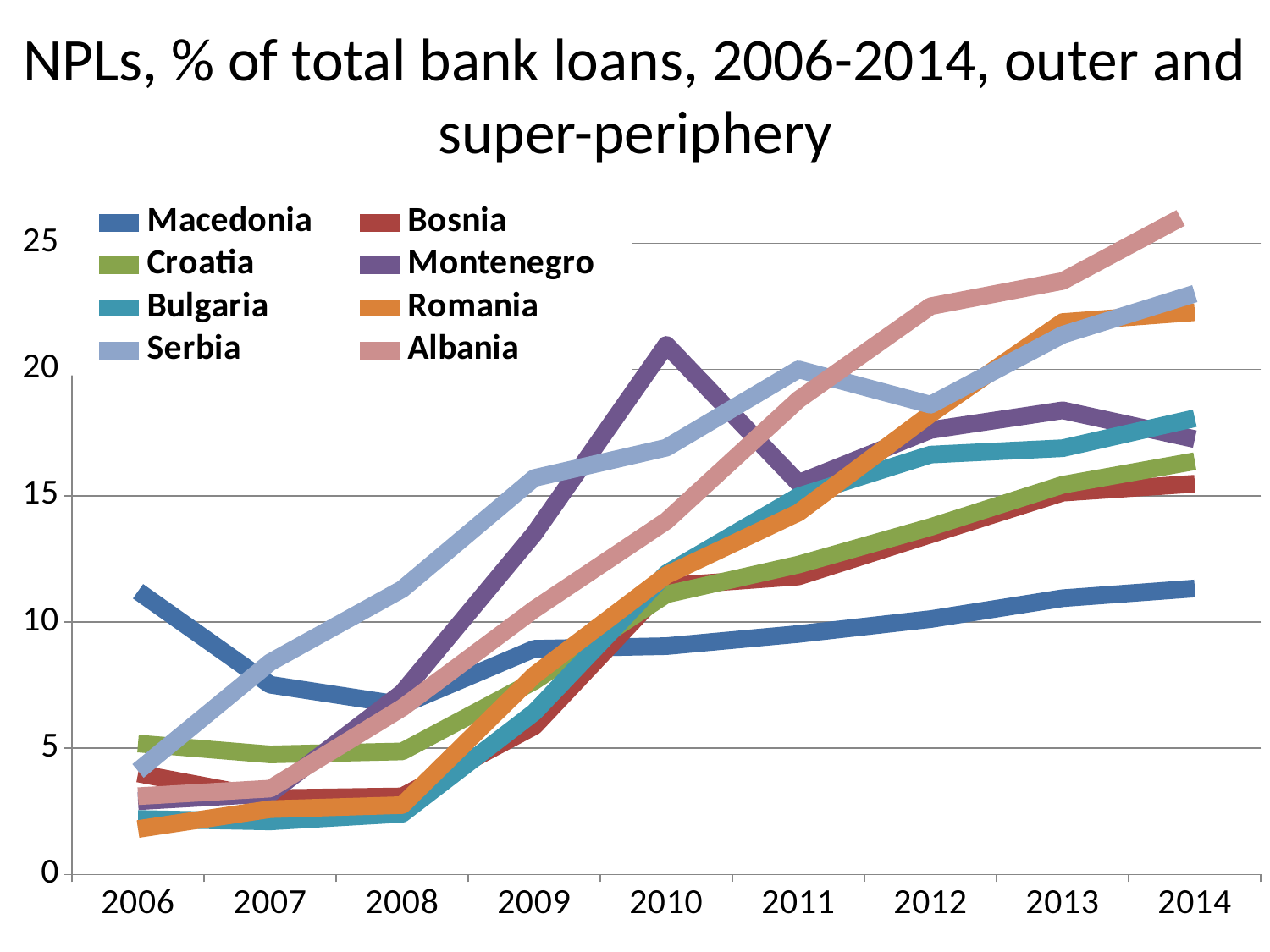
In 2014, which is larger, the value for Albania or the value for Serbia? Albania Is the value for Romania in 2006 greater or less than 5? less Which country has the lowest NPL ratio in 2014? Macedonia Does the value for Albania rise or fall from 2006 to 2014? rise Is the value for Montenegro in 2010 greater or less than 20? greater How many series does the legend list? 8 How many years are shown along the x axis? 9 Which country has the highest NPL ratio in 2014? Albania Which country has the highest NPL ratio in 2006? Macedonia Is the value for Albania in 2014 greater or less than 20? greater What kind of chart is shown on the slide? line chart Which country has the highest NPL ratio in 2010? Montenegro